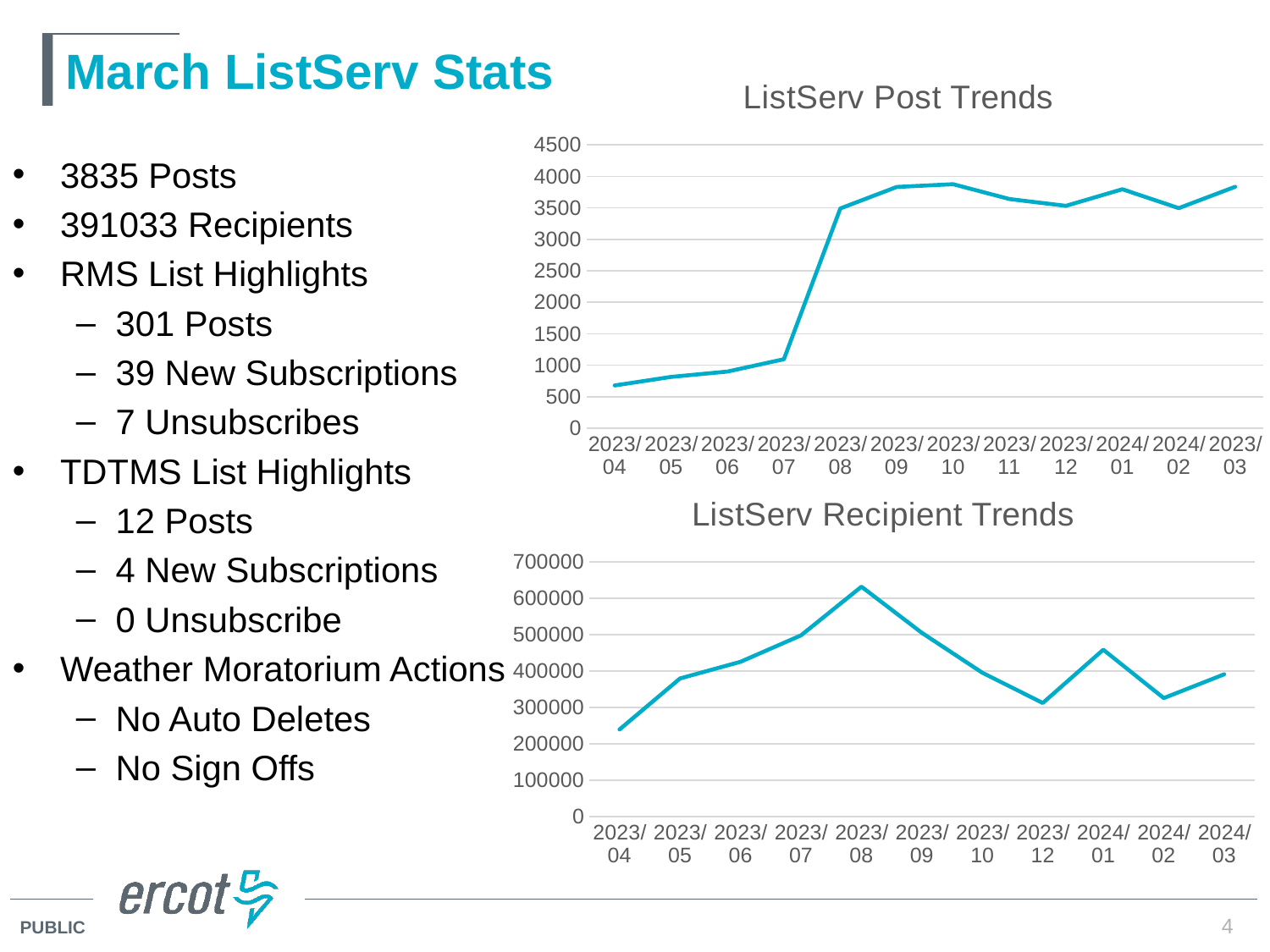
On the ListServ Recipient Trends chart, is the value for 2023/04 greater or less than 300000? less What kind of chart is the ListServ Post Trends chart? line chart On the ListServ Post Trends chart, is the value for 2023/08 greater or less than 3000? greater How many data points are plotted on the ListServ Post Trends chart? 12 On the ListServ Recipient Trends chart, which month has the highest value? 2023/08 How many data points are plotted on the ListServ Recipient Trends chart? 11 On the ListServ Recipient Trends chart, do the values rise or fall from 2023/08 to 2023/12? fall On the ListServ Recipient Trends chart, is the value for 2023/08 greater or less than 600000? greater On the ListServ Post Trends chart, which month has the lowest value? 2023/04 On the ListServ Recipient Trends chart, which month has the lowest value? 2023/04 On the ListServ Post Trends chart, which is larger, the value for 2023/07 or the value for 2023/08? 2023/08